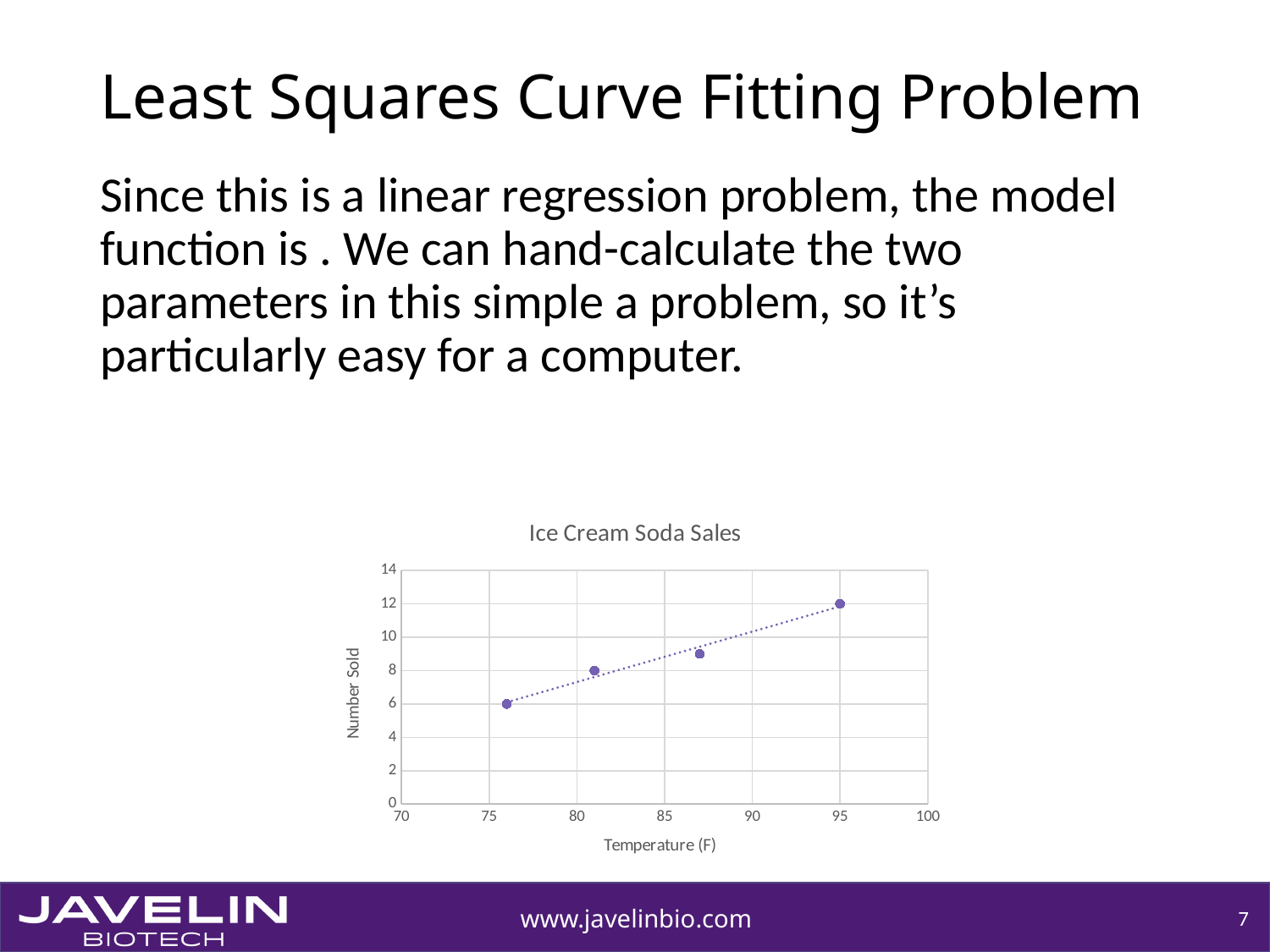
How many data points are plotted in the chart? 4 What is the number sold at a temperature of 95 F? 12 What is the title of the chart? Ice Cream Soda Sales Is the number sold for the leftmost point greater or less than 8? less Do the number sold values rise or fall as temperature increases? rise Is the number sold for the second point from the left greater or less than 10? less Is the number sold at 95 F greater or less than 10? greater What kind of chart is shown on the slide? scatter chart Which point has the lower number sold, the leftmost point or the rightmost point? leftmost What is the maximum value shown on the y axis? 14 At which temperature is the number sold highest? 95 What is the label of the x axis? Temperature (F)